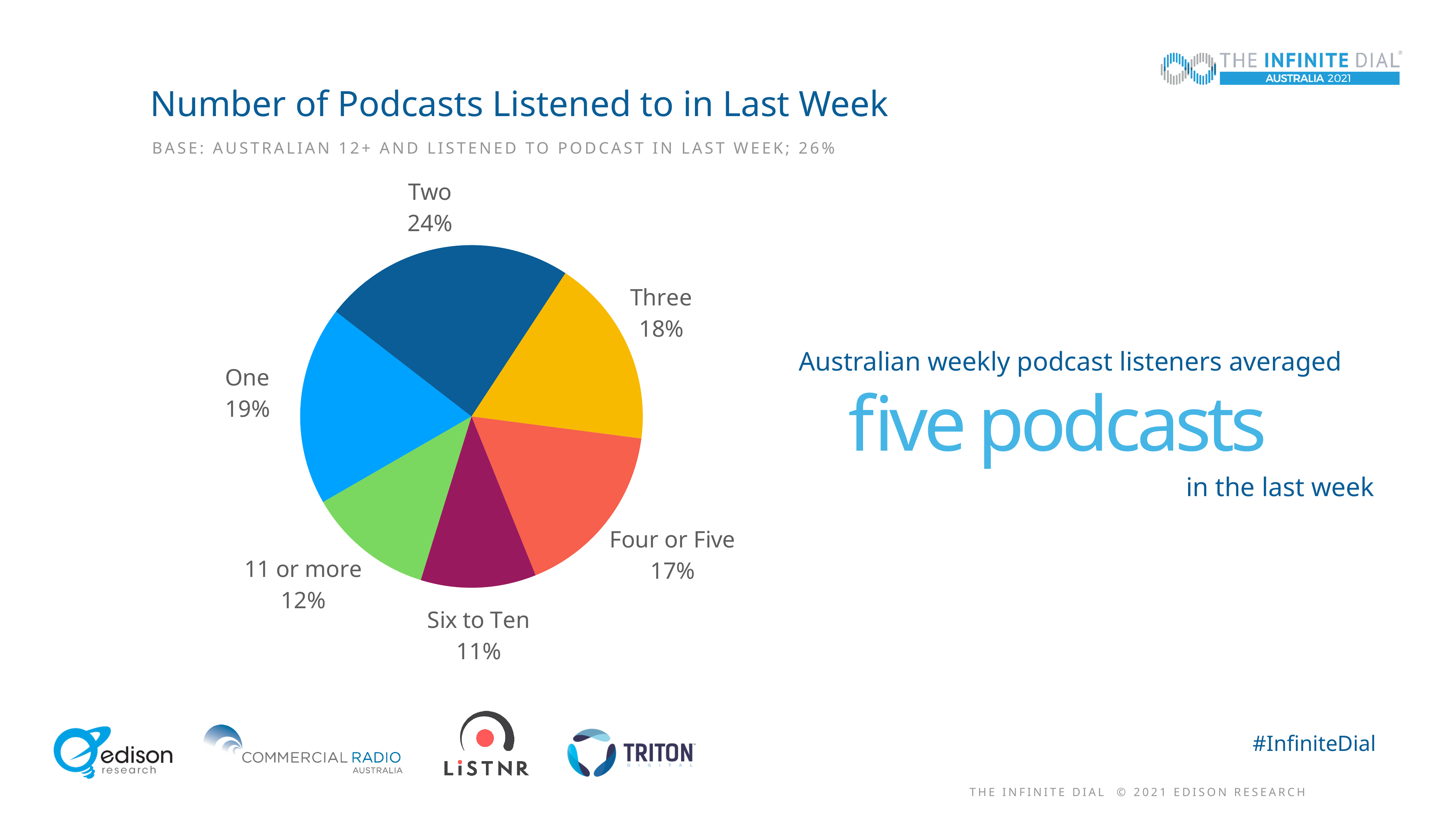
How many categories are shown in the pie chart? 6 What colour is the 'Three' slice of the pie? Yellow What kind of chart is shown on the slide? Pie chart What is the difference in percentage points between the 'Two' slice and the 'Three' slice? 6 Which category has the smallest slice of the pie? Six to Ten What share of the pie is labelled 'Six to Ten'? 11% What percentage of weekly podcast listeners listened to two podcasts in the last week? 24% Which is larger, the 'One' slice or the 'Four or Five' slice? One What is the value shown for the 'One' slice? 19% What percentage is shown for '11 or more'? 12% Which category has the largest slice of the pie? Two What is the title of the chart? Number of Podcasts Listened to in Last Week